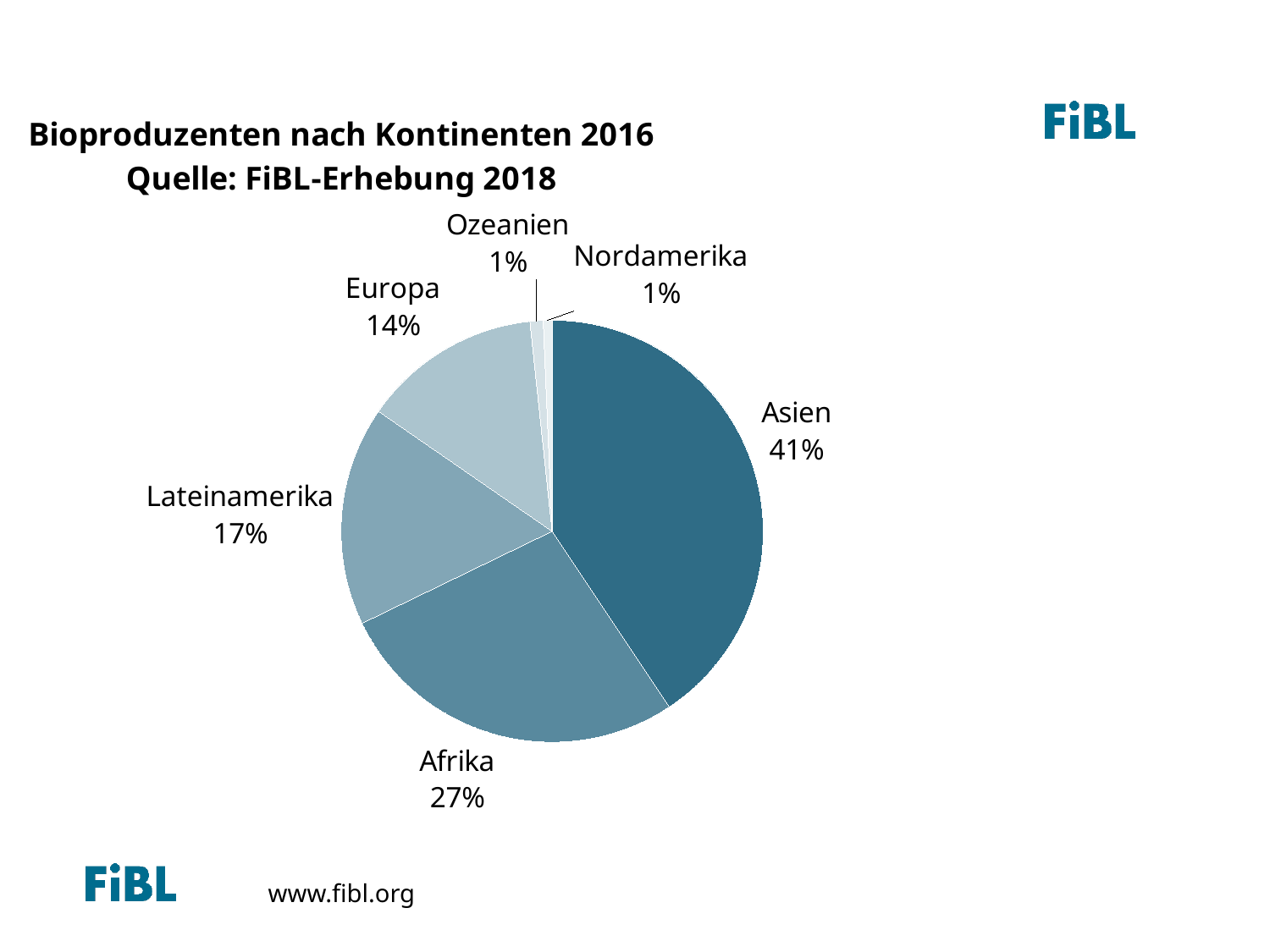
What is the difference in percentage points between Asien and Afrika? 14 Which is larger, the slice for Afrika or the slice for Lateinamerika? Afrika What kind of chart is shown on the slide? Pie chart What is the difference in percentage points between Lateinamerika and Europa? 3 What is the value shown for Europa? 14% How many continents are shown in the pie chart? 6 What is the value shown for Lateinamerika? 17% What source is given for the chart data? FiBL-Erhebung 2018 Which continent has the largest slice of the pie? Asien What is the value shown for Afrika? 27% What is the title of the chart? Bioproduzenten nach Kontinenten 2016 What share of the pie does Asien have? 41%